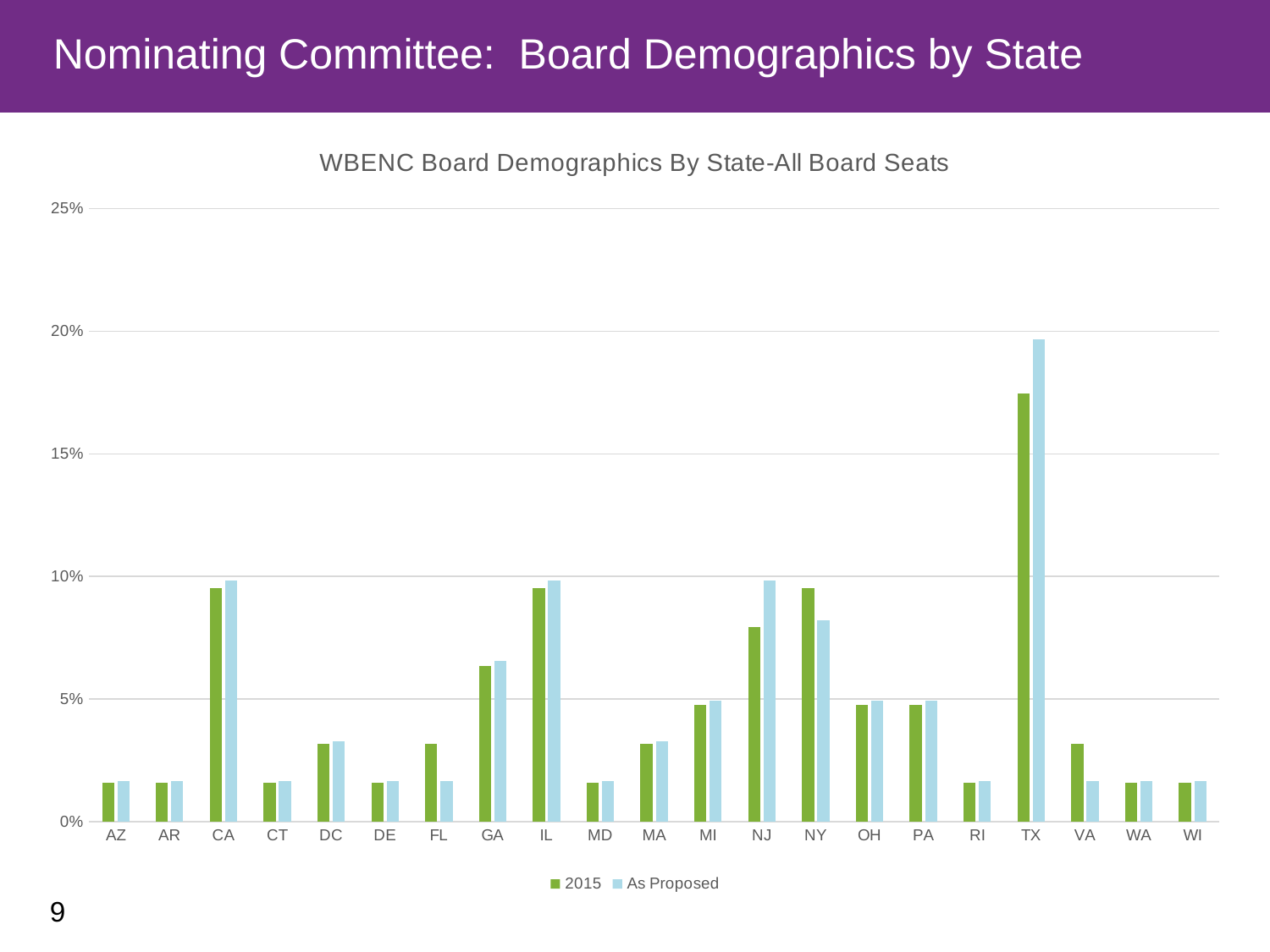
Which is larger for the As Proposed series: NJ or NY? NJ Is the As Proposed value for TX greater or less than 15%? greater Which state has the highest value for the 2015 series? TX Which state has the highest value for the As Proposed series? TX What is the title of the chart? WBENC Board Demographics By State-All Board Seats Is the 2015 value for TX greater or less than 15%? greater Is the 2015 value for GA greater or less than 5%? greater How many states are shown on the x axis of the chart? 21 What kind of chart is shown on the slide? bar chart For VA, which series has the larger value: 2015 or As Proposed? 2015 How many series does the legend list? 2